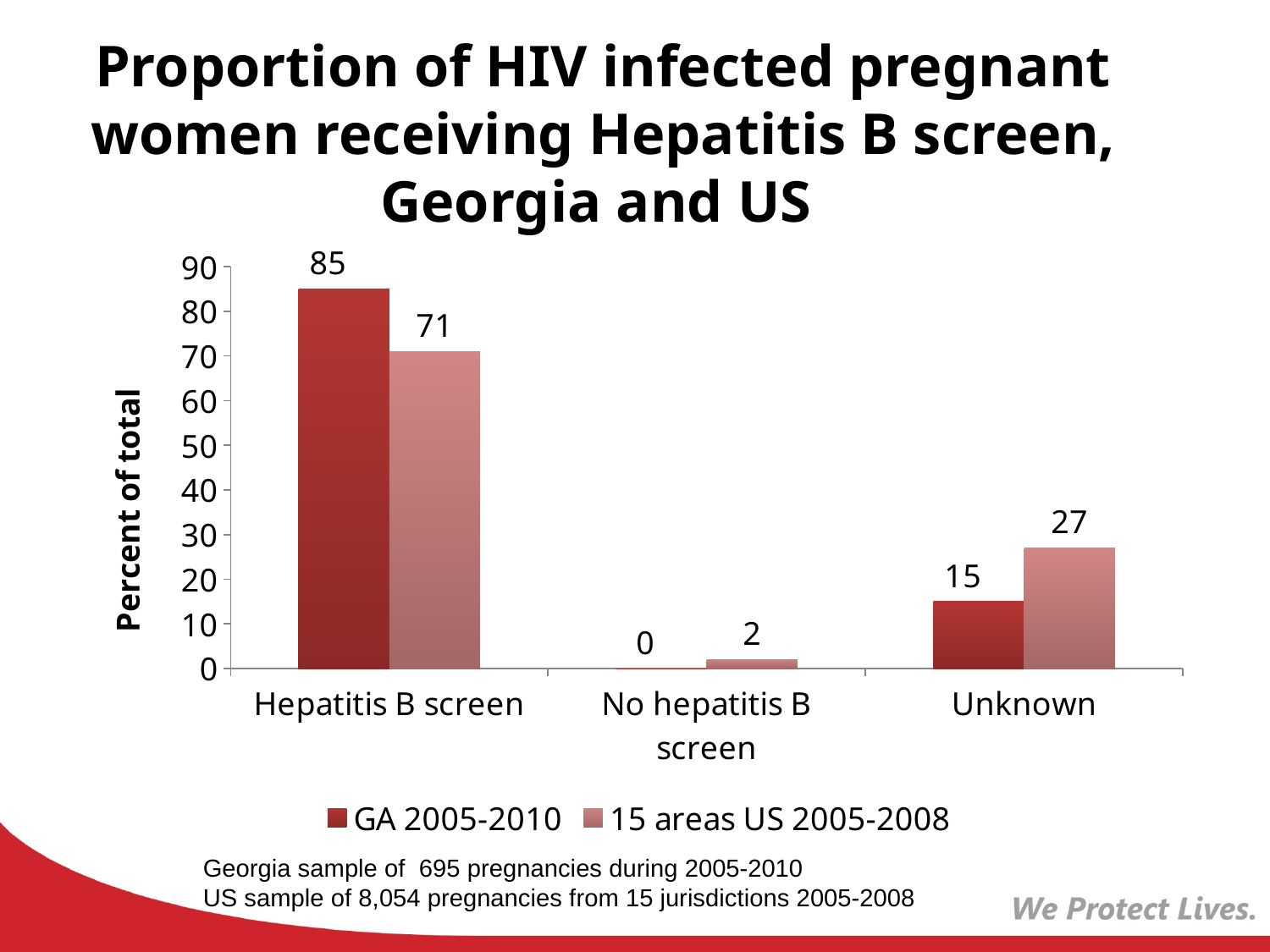
What is the value for 15 areas US 2005-2008 in the No hepatitis B screen category? 2 What is the label of the vertical axis? Percent of total What is the value for 15 areas US 2005-2008 in the Unknown category? 27 What is the difference between the GA 2005-2010 and 15 areas US 2005-2008 values in the Hepatitis B screen category? 14 How many series does the legend list? 2 What is the value for GA 2005-2010 in the Unknown category? 15 How many categories are shown on the x axis? 3 In the Unknown category, which series has the larger value, GA 2005-2010 or 15 areas US 2005-2008? 15 areas US 2005-2008 What is the value for GA 2005-2010 in the Hepatitis B screen category? 85 Which category has the lowest value for the 15 areas US 2005-2008 series? No hepatitis B screen Which category has the highest value for the GA 2005-2010 series? Hepatitis B screen What kind of chart is shown on the slide? Bar chart